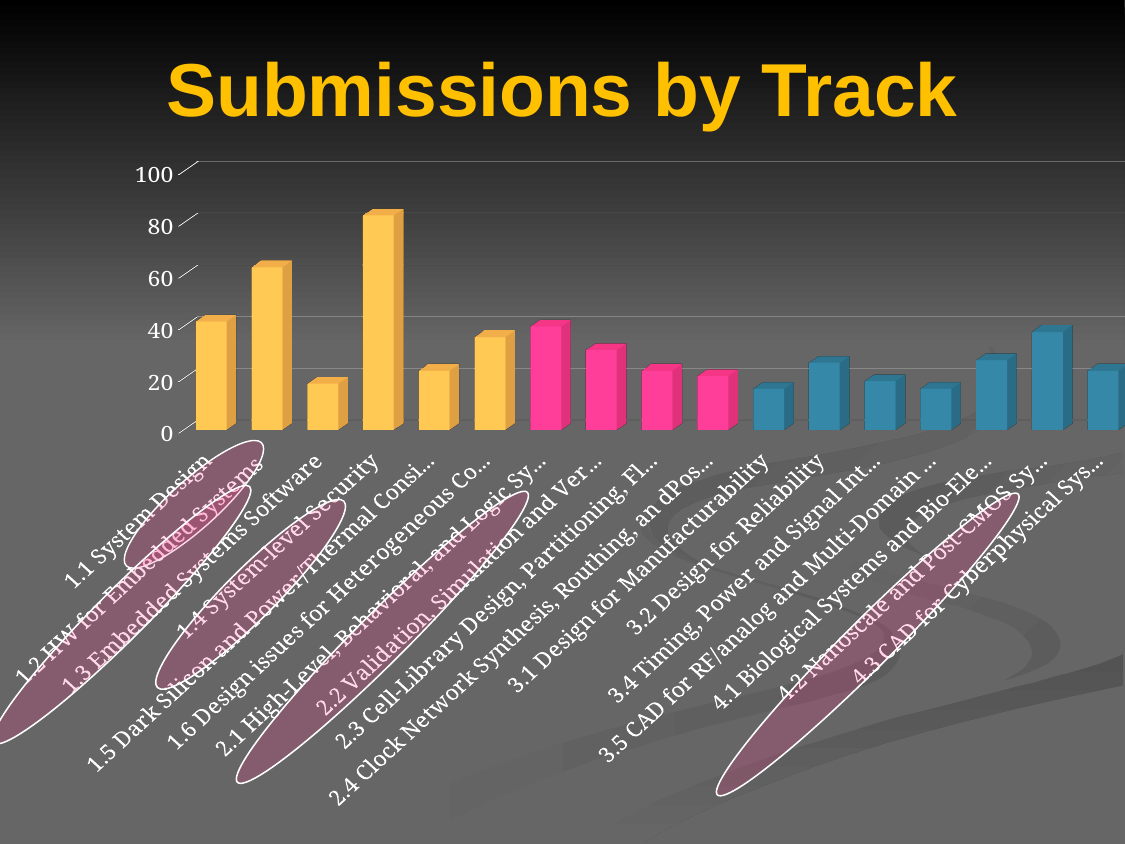
Which track has the highest number of submissions? 1.4 System-level Security What kind of chart is shown on the slide? bar chart What is the title of the chart? Submissions by Track How many different bar colours are used in the chart? 3 Is the value for 3.1 Design for Manufacturability greater or less than 20? less Which has more submissions: 1.2 HW for Embedded Systems or 1.1 System Design? 1.2 HW for Embedded Systems Is the value for 1.2 HW for Embedded Systems greater or less than 60? greater Which has more submissions: 3.2 Design for Reliability or 3.1 Design for Manufacturability? 3.2 Design for Reliability How many tracks (bars) are shown in the chart? 17 Is the value for 1.4 System-level Security greater or less than 80? greater